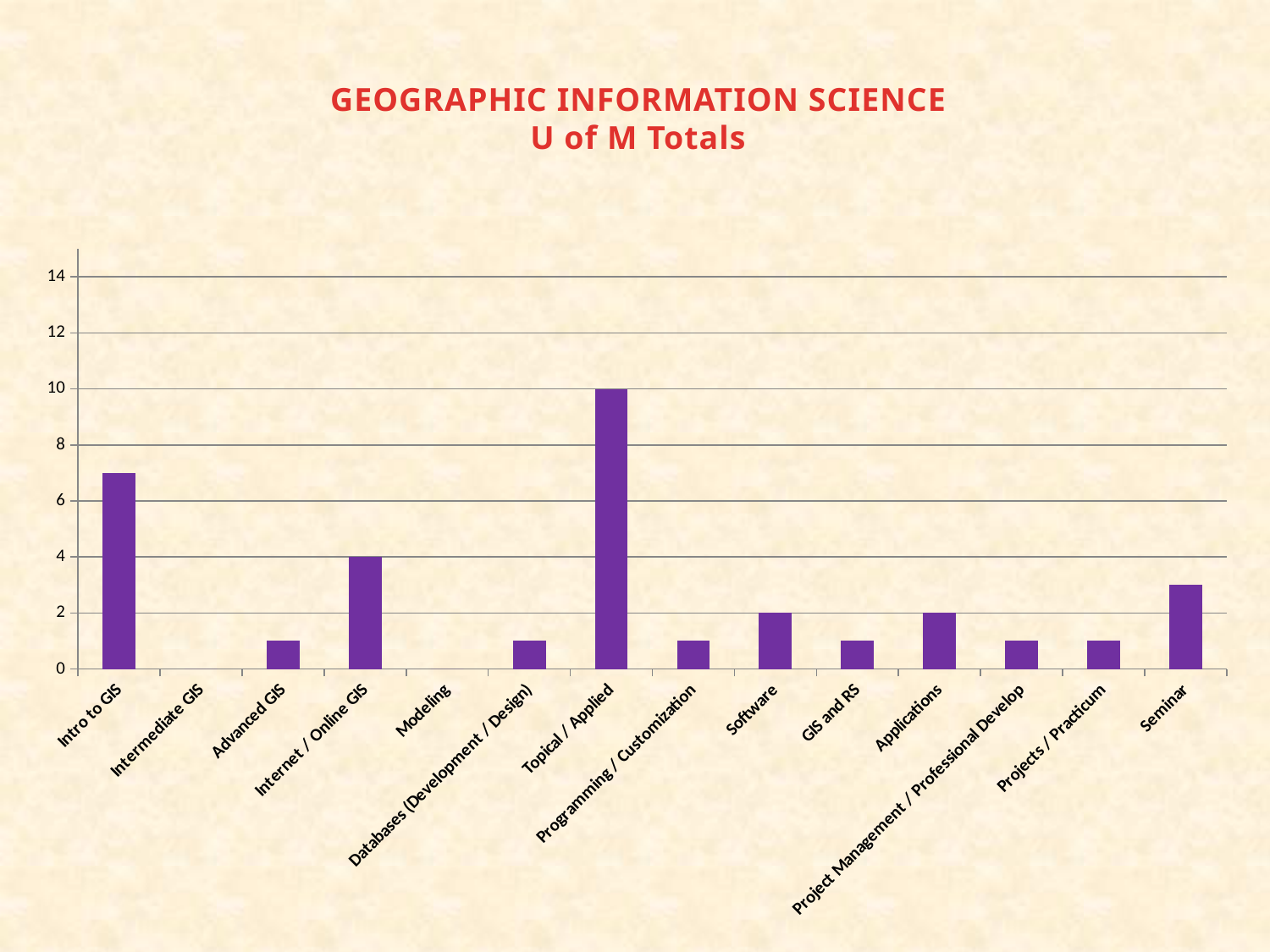
What type of chart is shown on the slide? bar chart What is the title of the chart? GEOGRAPHIC INFORMATION SCIENCE U of M Totals Is the value for Seminar greater or less than 4? less Is the value for Intro to GIS greater or less than 6? greater What is the value for Internet / Online GIS? 4 What is the value for Topical / Applied? 10 What is the value for Applications? 2 Which is larger, the value for Intro to GIS or the value for Seminar? Intro to GIS How many categories are shown on the x axis? 14 What is the value for Software? 2 What is the difference between the values for Topical / Applied and Internet / Online GIS? 6 Which category has the highest value? Topical / Applied